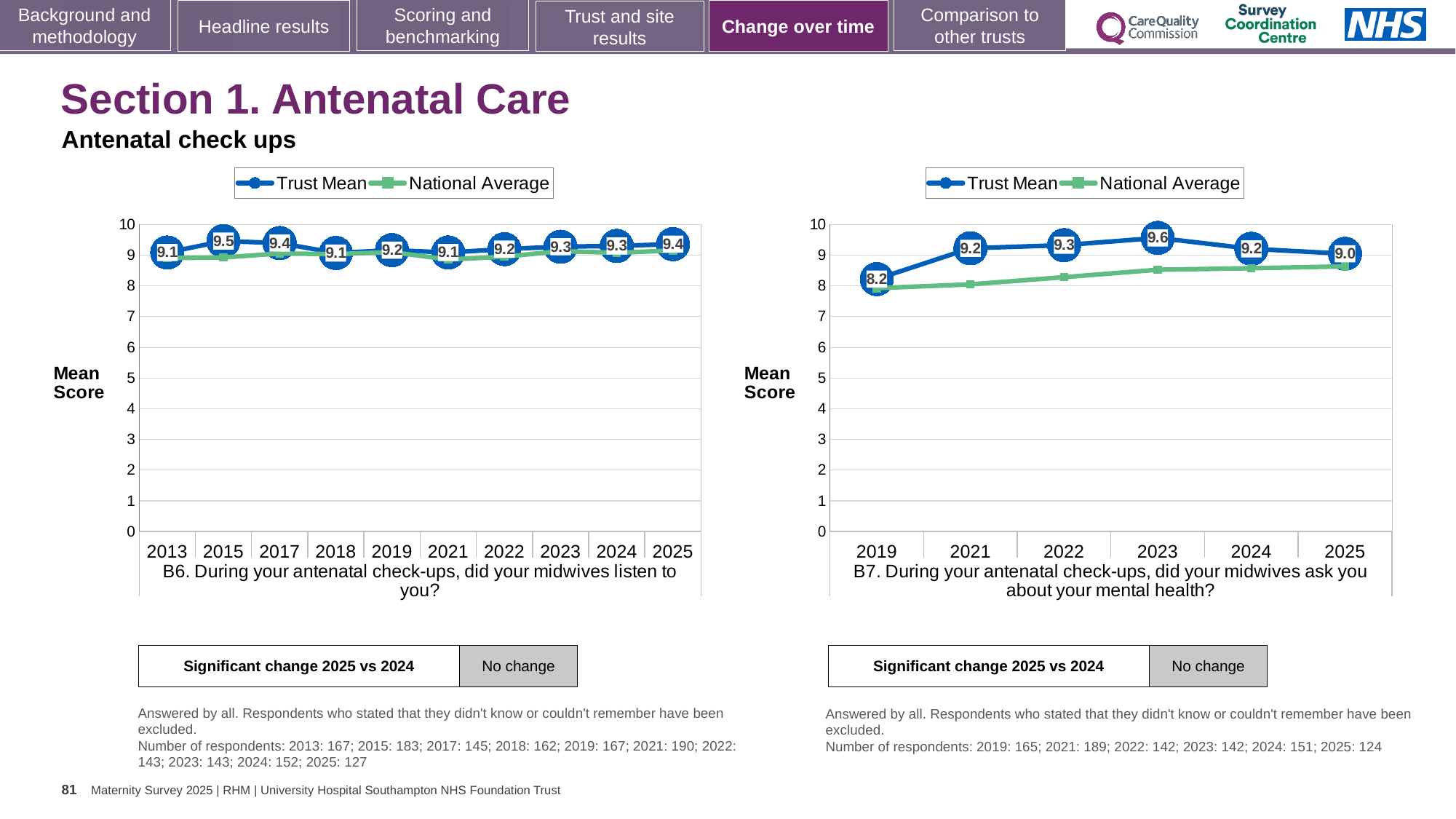
In the B7 chart (right), what is the Trust Mean for 2023? 9.6 In the B7 chart (right), what is the difference between the Trust Mean in 2023 and in 2019? 1.4 In the B6 chart (left), is the Trust Mean higher in 2015 or in 2018? 2015 In the B7 chart (right), which year has the highest Trust Mean? 2023 How many years are plotted on the x axis of the B6 chart (left)? 10 In the B7 chart (right), is the National Average for 2019 greater or less than 9? less In the B6 chart (left), what is the Trust Mean for 2015? 9.5 In the B7 chart (right), what is the Trust Mean for 2019? 8.2 In the B6 chart (left), what is the Trust Mean for 2025? 9.4 What kind of chart is the B6 chart (left)? Line chart How many series does the legend of the B7 chart (right) list? 2 In the B7 chart (right), which year has the lowest Trust Mean? 2019